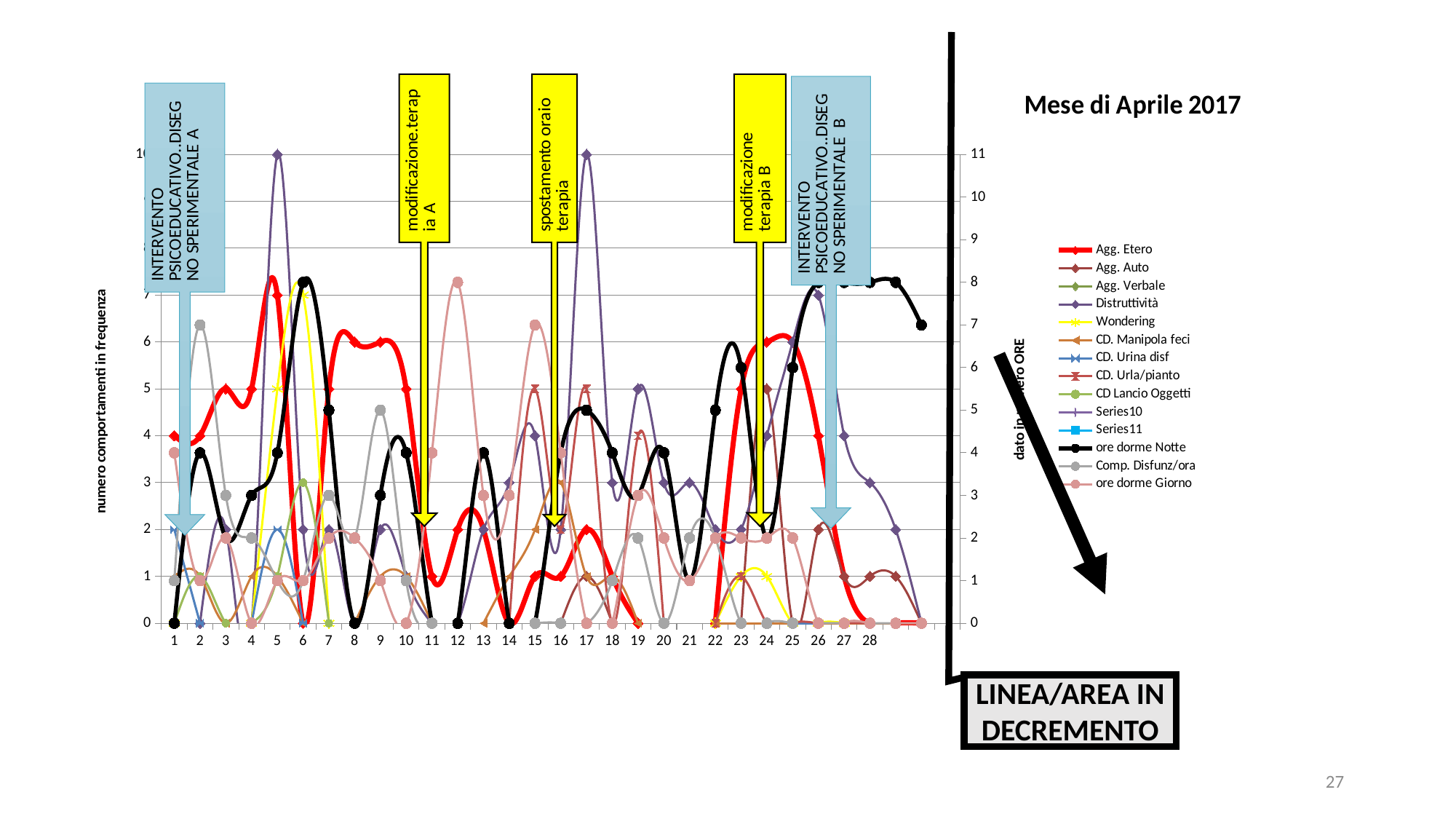
Is the value for Agg. Etero on day 11 greater or less than 2? less How many series does the legend list? 14 Which is larger for Distruttività: the value on day 5 or the value on day 6? day 5 What is the value of Agg. Etero on day 6? 0 Is the value for Agg. Etero on day 5 greater or less than 6? greater What kind of chart is shown on the slide? line chart Is the value for Distruttività on day 5 greater or less than 8? greater What colour is the Agg. Etero line in the legend? red What is the title shown above the chart? Mese di Aprile 2017 What is the value of ore dorme Notte on day 8? 0 Does the Agg. Etero line rise or fall from day 25 to day 28? fall